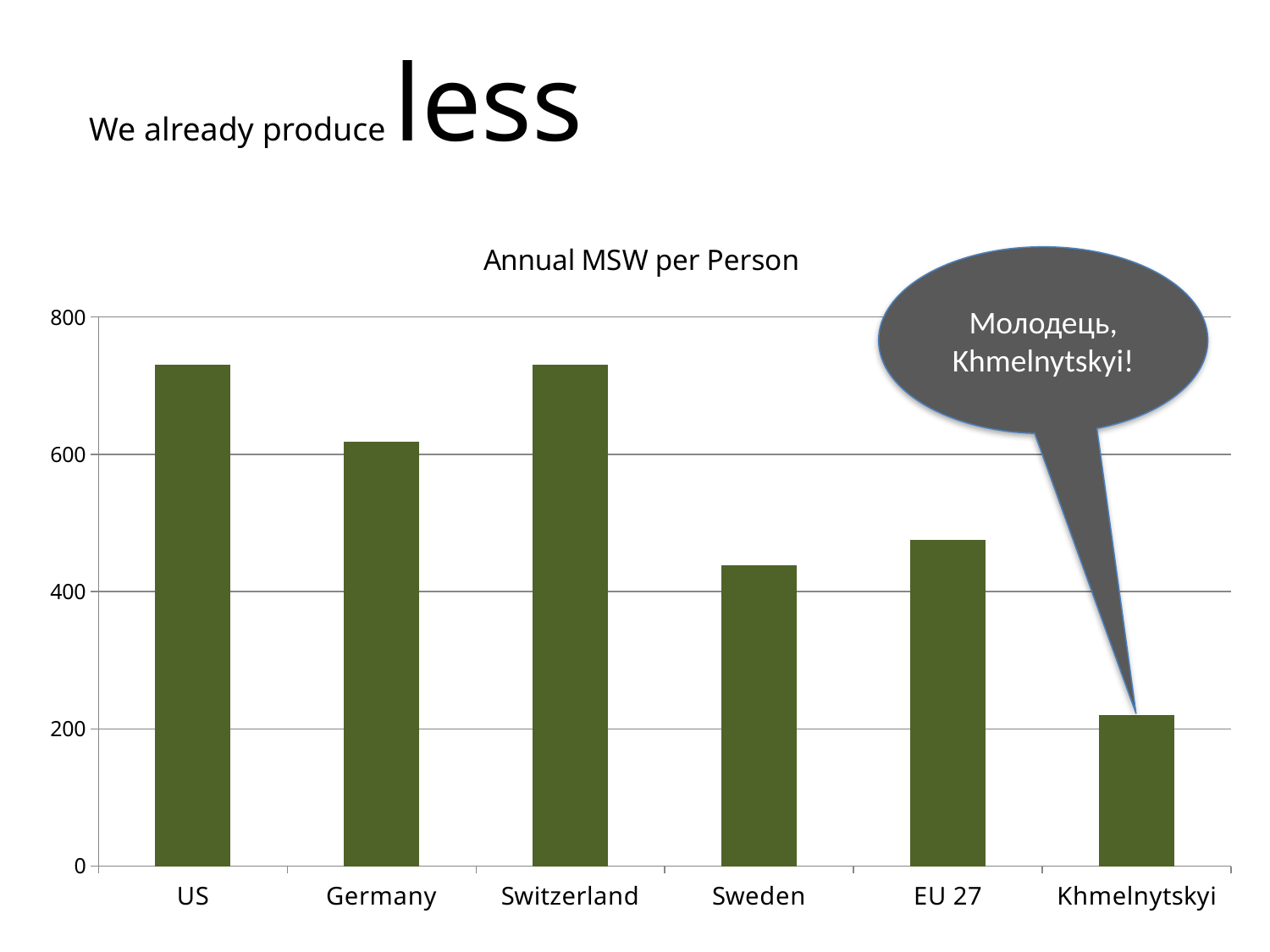
Is the value for EU 27 greater or less than 600? less Is the value for Khmelnytskyi greater or less than 400? less Is the value for Germany greater or less than 400? greater How many categories are shown on the x axis of the chart? 6 Which has a larger value, Switzerland or Khmelnytskyi? Switzerland Which has a larger value, Germany or Sweden? Germany What is the title of the chart? Annual MSW per Person Which category has the lowest value in the chart? Khmelnytskyi What kind of chart is shown on the slide? bar chart What colour are the bars in the chart? green